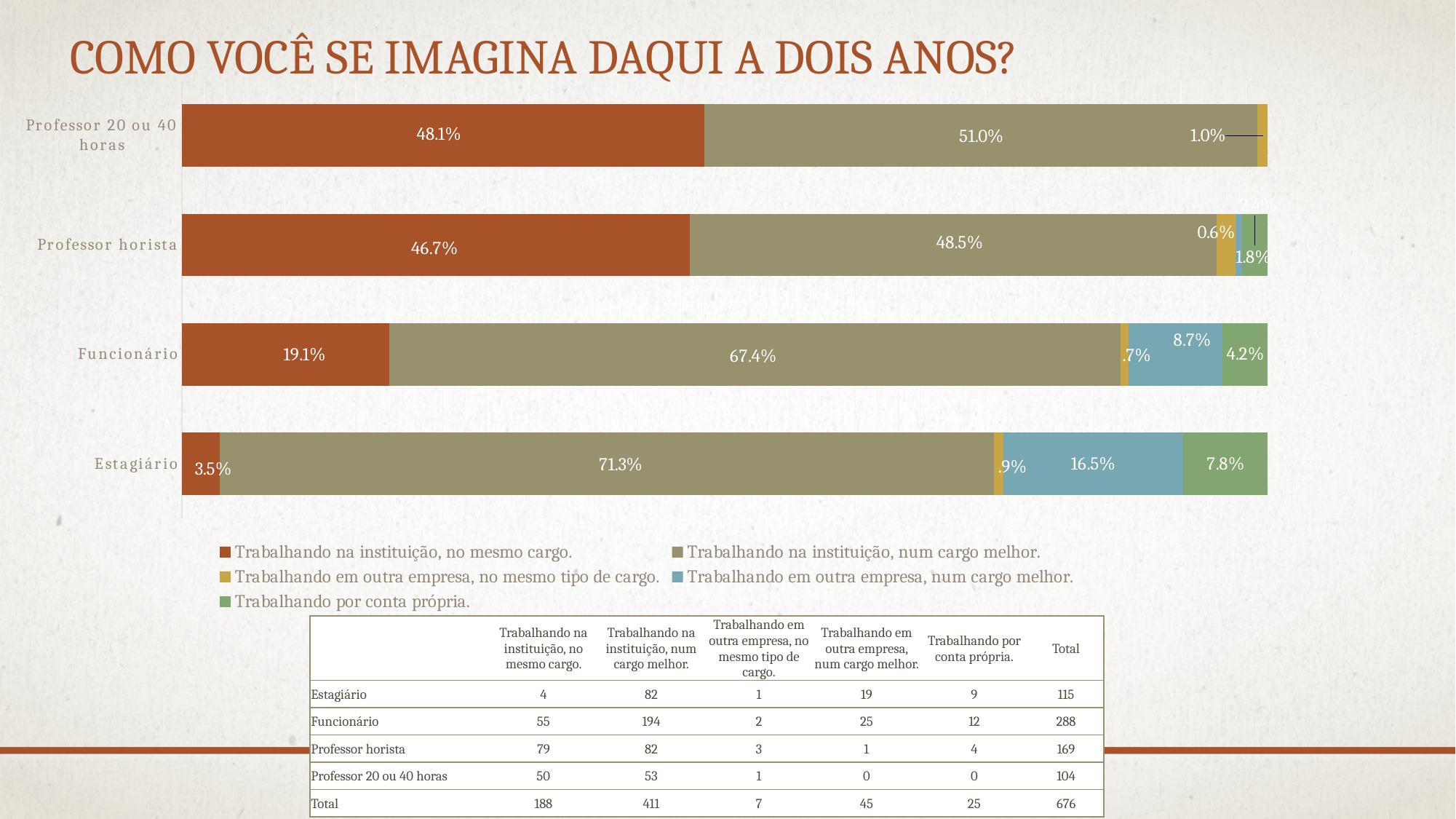
What is the difference between the 'Trabalhando na instituição, num cargo melhor' values for Estagiário and Funcionário? 3.9% Which category has the highest value for 'Trabalhando na instituição, no mesmo cargo'? Professor 20 ou 40 horas Which colour represents 'Trabalhando por conta própria' in the chart? green How many series does the chart legend list? 5 What is the value for 'Trabalhando por conta própria' for Estagiário? 7.8% What is the value for 'Trabalhando na instituição, no mesmo cargo' for Professor 20 ou 40 horas? 48.1% What is the value for 'Trabalhando na instituição, num cargo melhor' for Estagiário? 71.3% What kind of chart is shown on the slide? stacked bar chart What is the value for 'Trabalhando em outra empresa, num cargo melhor' for Funcionário? 8.7% How many categories are plotted on the chart? 4 Which category has the lowest value for 'Trabalhando na instituição, no mesmo cargo'? Estagiário Which is larger: the 'Trabalhando em outra empresa, num cargo melhor' value for Estagiário or for Funcionário? Estagiário